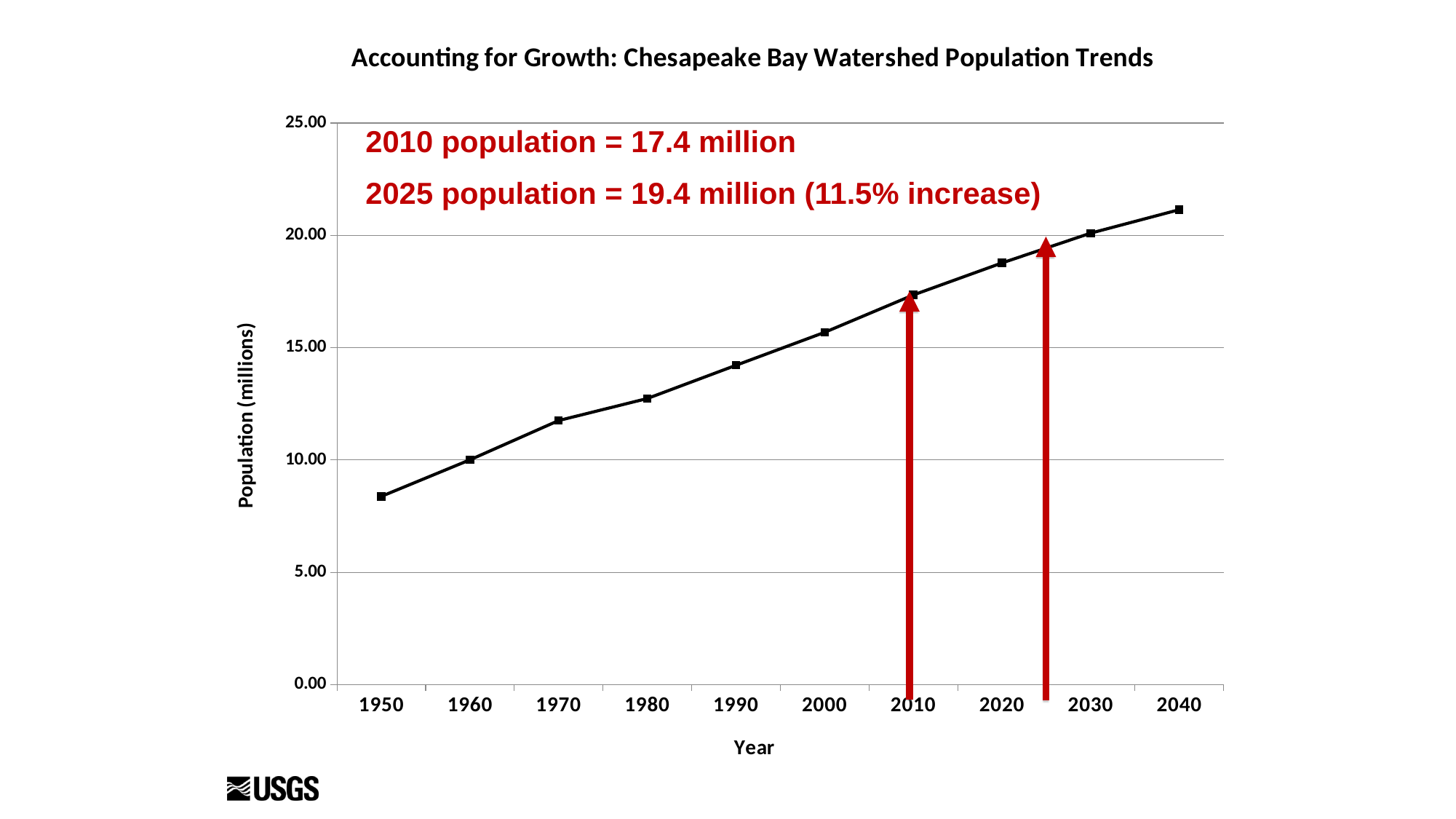
Does the population rise or fall from 1950 to 2040? rise What is the difference between the 2025 population and the 2010 population stated on the slide? 2.0 million Which year has the lowest plotted population? 1950 What is the label of the vertical axis? Population (millions) According to the annotation on the slide, what is the 2025 population? 19.4 million According to the annotation on the slide, what is the 2010 population? 17.4 million What is the title of the chart? Accounting for Growth: Chesapeake Bay Watershed Population Trends What kind of chart is shown on the slide? line chart Is the value for 2040 greater or less than 20.00? greater Is the value for 1950 greater or less than 10.00? less Which year has the highest plotted population? 2040 How many data points are plotted on the line? 10